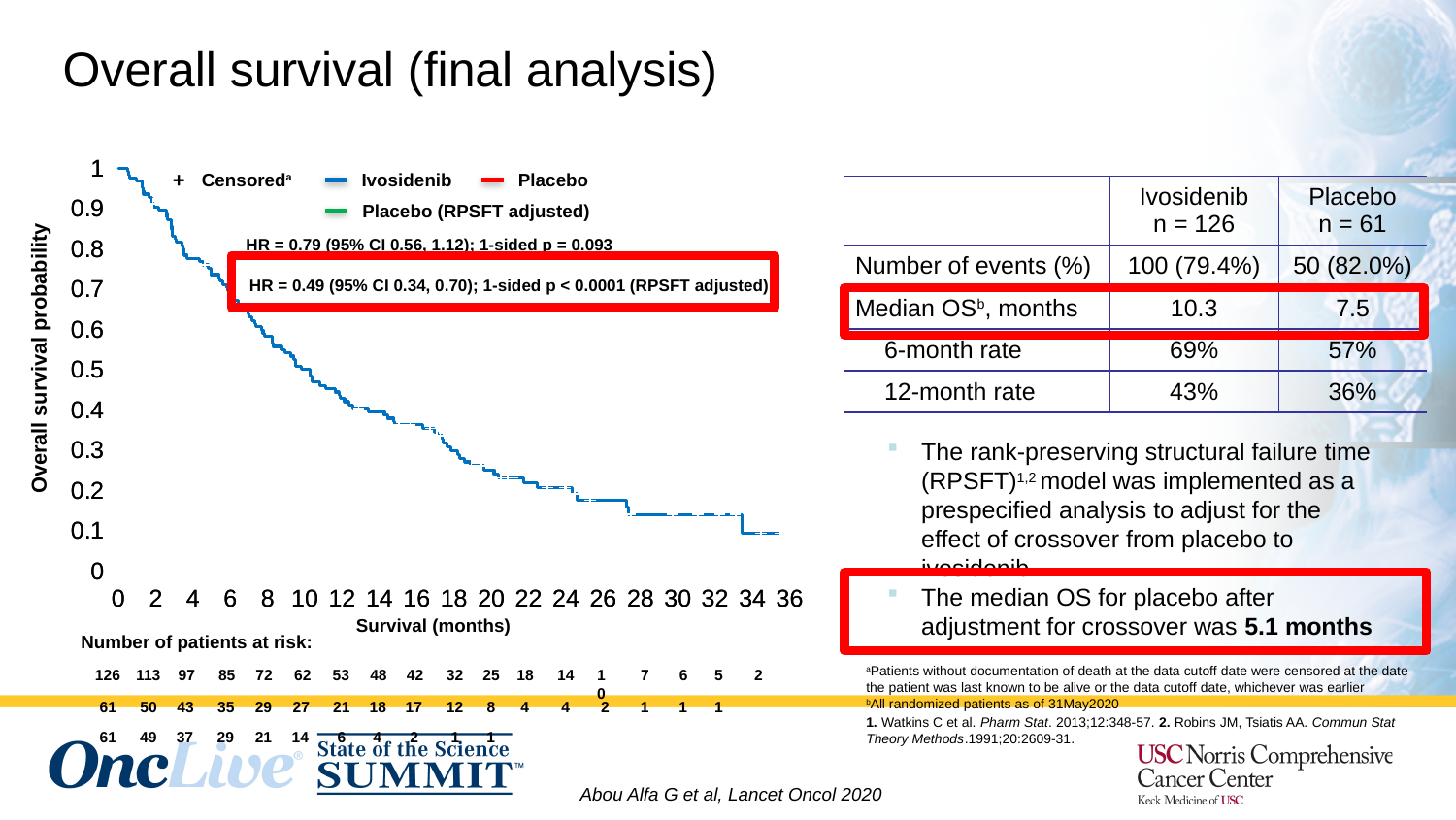
Is the ivosidenib survival probability at 4 months greater or less than 0.6? greater What is the label of the y axis of the chart? Overall survival probability What is the label of the x axis of the chart? Survival (months) What hazard ratio is printed on the chart for the unadjusted comparison? HR = 0.79 What hazard ratio is printed on the chart for the RPSFT adjusted comparison? HR = 0.49 What is the highest value shown on the x axis of the chart? 36 What kind of chart is shown on the slide? line chart According to the number of patients at risk below the chart, how many ivosidenib patients were at risk at 0 months? 126 Is the ivosidenib survival probability at 20 months greater or less than 0.3? less How many entries does the chart legend list? 4 According to the number of patients at risk below the chart, how many placebo patients were at risk at 0 months? 61 According to the number of patients at risk below the chart, how many ivosidenib patients were at risk at 12 months? 53